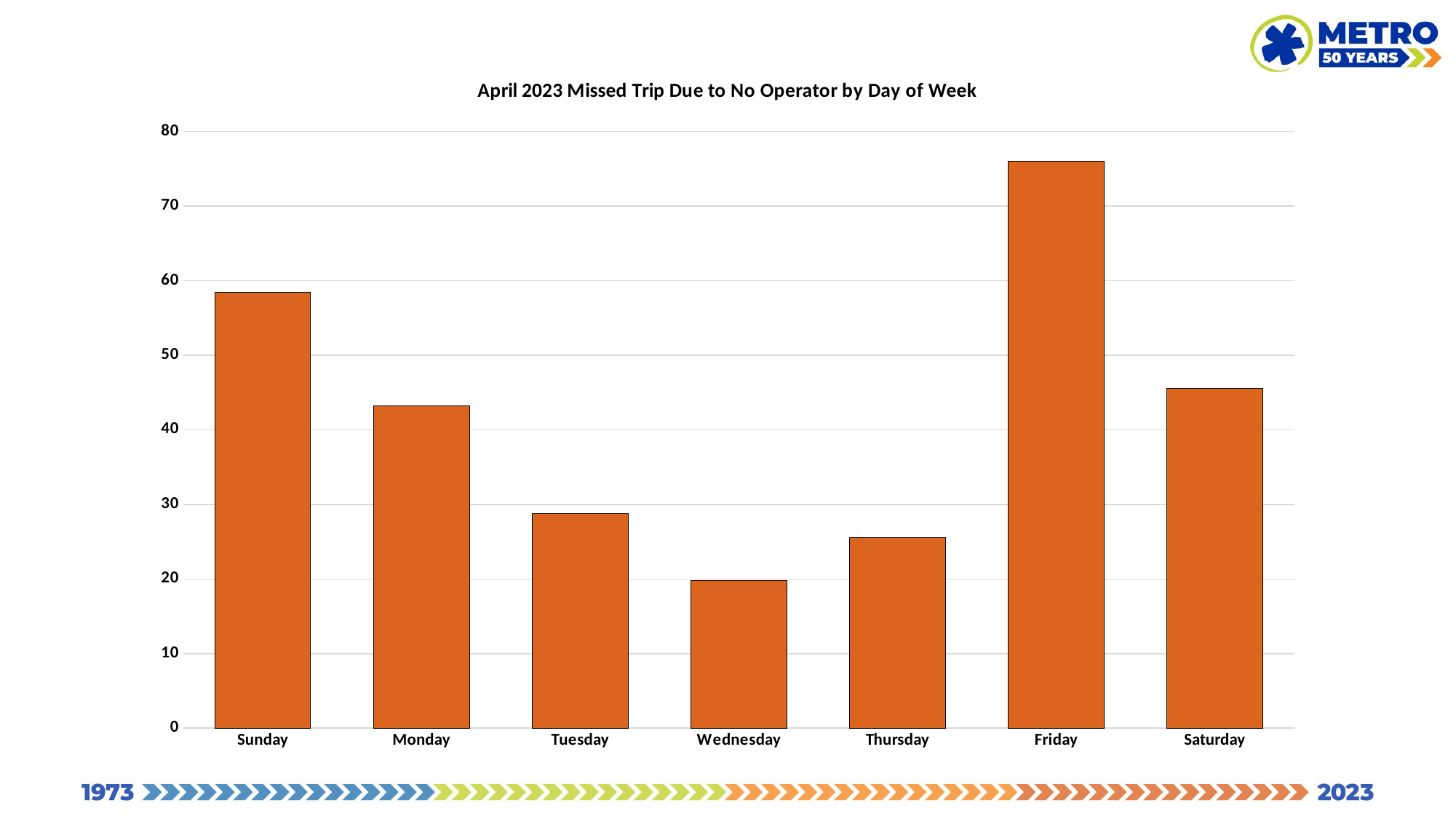
Is the value for Thursday greater or less than 30? less Which day of the week has the highest number of missed trips? Friday Is the value for Monday greater or less than 40? greater Is the value for Saturday greater or less than 50? less Which has more missed trips, Sunday or Saturday? Sunday What type of chart is shown on the slide? bar chart What is the title of the chart? April 2023 Missed Trip Due to No Operator by Day of Week How many days of the week are shown on the x axis? 7 Do the values rise or fall from Sunday to Wednesday? fall Which day of the week has the lowest number of missed trips? Wednesday